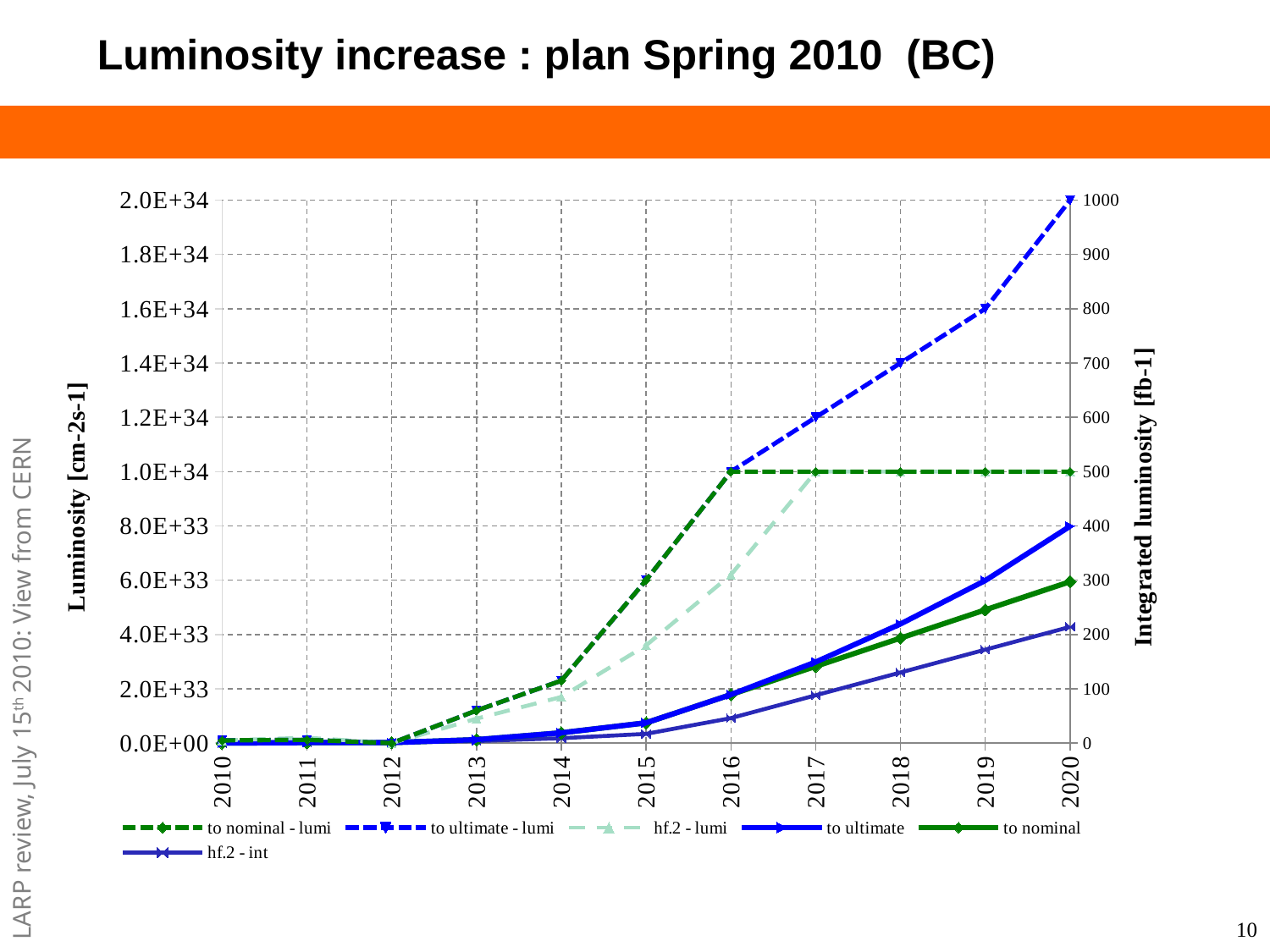
What is the title of the right-hand y axis? Integrated luminosity [fb-1] Is the value of the 'to ultimate' series in 2020 greater or less than 300 on the right axis? greater What is the difference between the 'to ultimate - lumi' and 'to nominal - lumi' values in 2020? 1.0E+34 In 2020, which is larger: 'to ultimate - lumi' or 'to nominal - lumi'? to ultimate - lumi What is the value of the 'to nominal - lumi' series in 2018? 1.0E+34 Does the 'to ultimate - lumi' series rise or fall from 2010 to 2020? rise What is the value of the 'to ultimate - lumi' series in 2019? 1.6E+34 How many years are shown along the x axis? 11 How many series does the legend list? 6 Is the value of the 'hf.2 - int' series in 2020 greater or less than 300 on the right axis? less What kind of chart is shown on the slide? line chart What is the value of the 'to ultimate - lumi' series in 2020? 2.0E+34